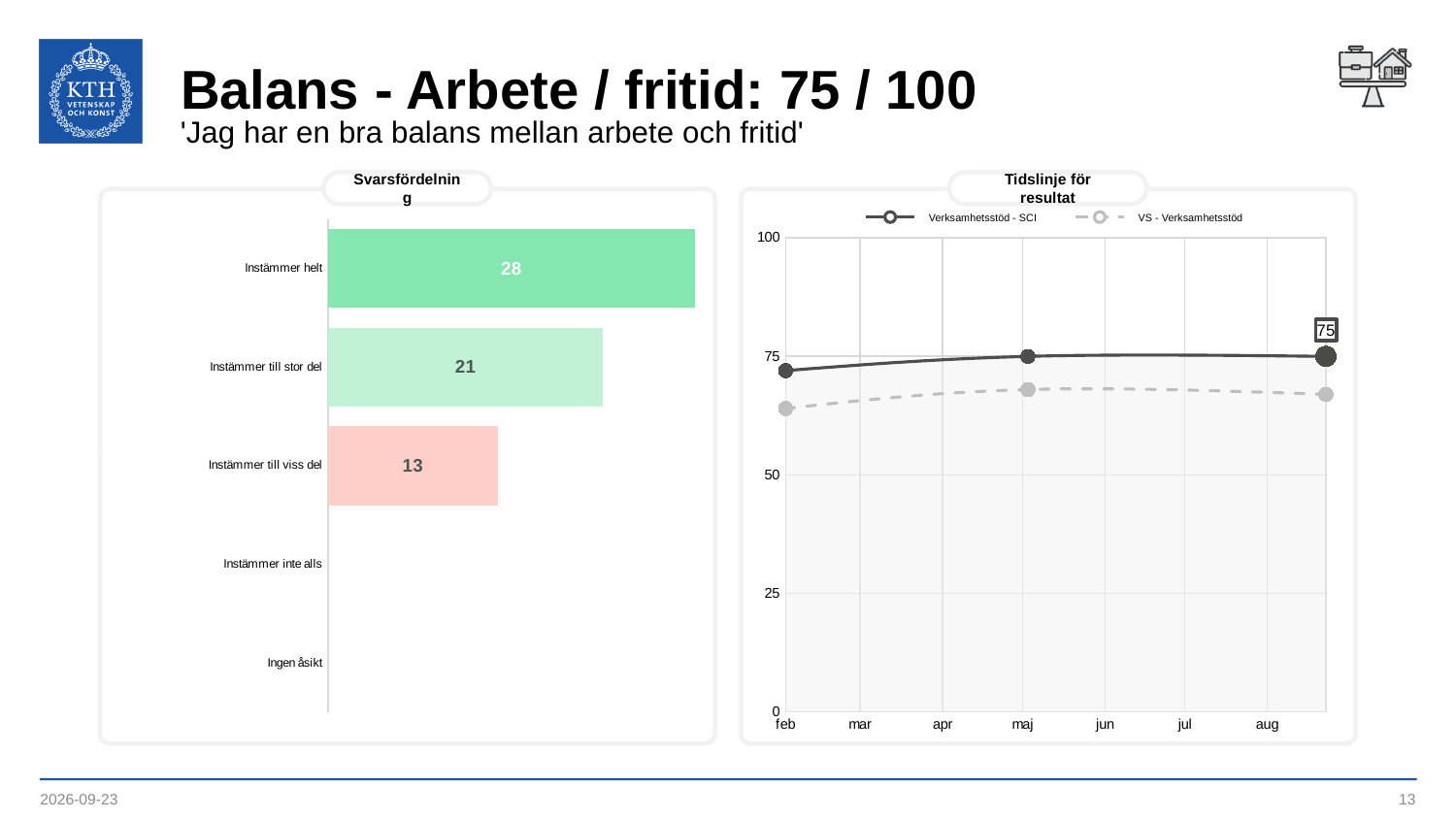
In the Tidslinje för resultat chart, is the value for Verksamhetsstöd - SCI in feb greater or less than 50? greater What kind of chart is the Svarsfördelning chart? Bar chart In the Tidslinje för resultat chart, how many series does the legend list? 2 In the Svarsfördelning chart, how many categories are listed on the axis? 5 In the Svarsfördelning chart, what is the value for Instämmer till stor del? 21 In the Svarsfördelning chart, which category has the highest value? Instämmer helt In the Tidslinje för resultat chart, what is the labelled value of the last point for Verksamhetsstöd - SCI? 75 In the Svarsfördelning chart, what is the value for Instämmer helt? 28 In the Tidslinje för resultat chart, which series has the higher value in maj? Verksamhetsstöd - SCI In the Tidslinje för resultat chart, is the value for VS - Verksamhetsstöd in feb greater or less than 75? less In the Svarsfördelning chart, what is the value for Instämmer till viss del? 13 In the Svarsfördelning chart, what is the difference between Instämmer helt and Instämmer till viss del? 15